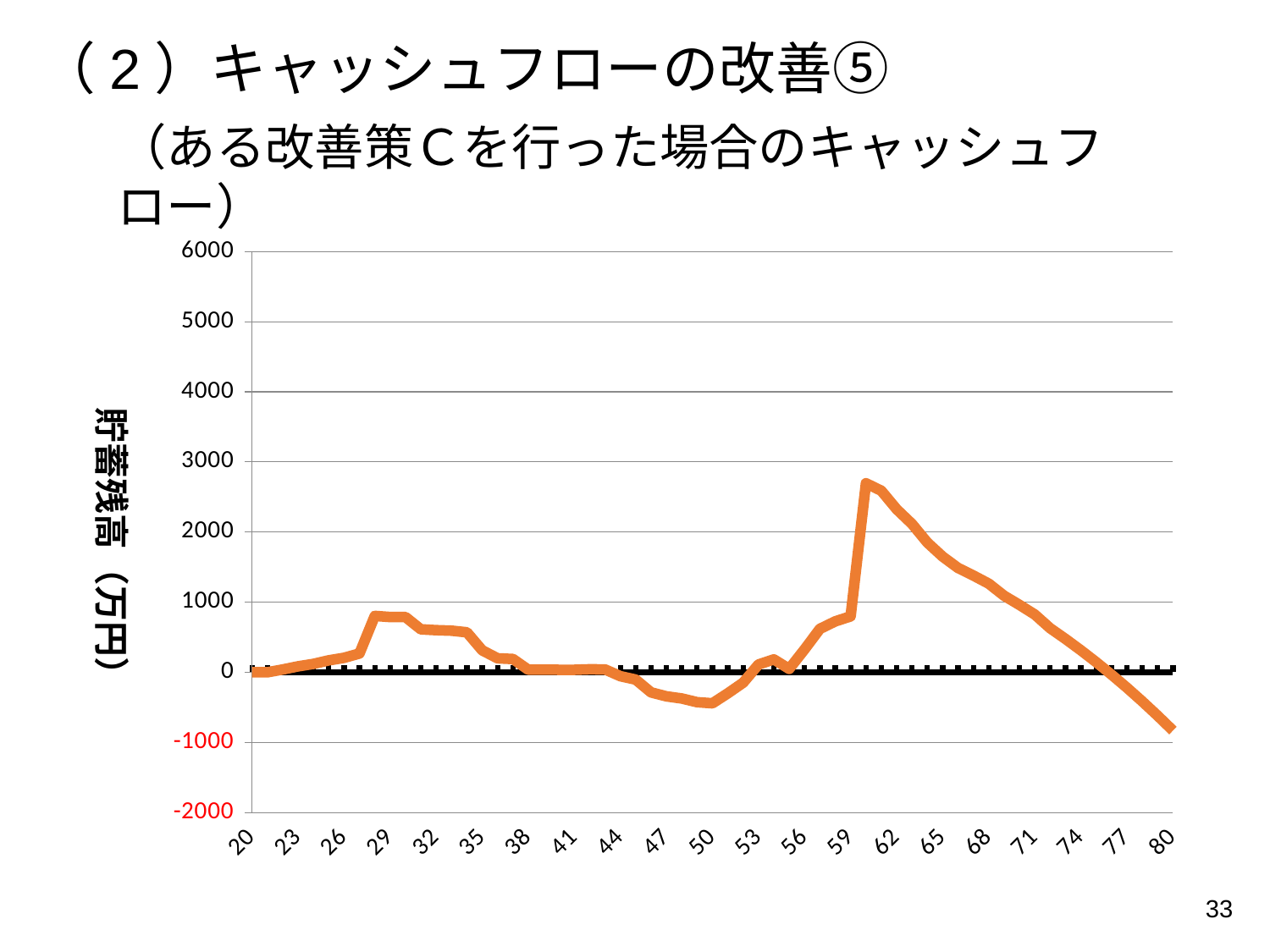
Do the values rise or fall from age 62 to age 80? fall Is the value at age 80 greater or less than -500? less Is the value at age 50 greater or less than 0? less Is the value at age 29 greater or less than 1000? less What kind of chart is shown on the slide? line chart What is the highest value shown on the vertical axis? 6000 What is the label on the vertical axis of the chart? 貯蓄残高（万円） Which is larger, the value at age 62 or the value at age 29? age 62 How many age labels are shown along the horizontal axis? 21